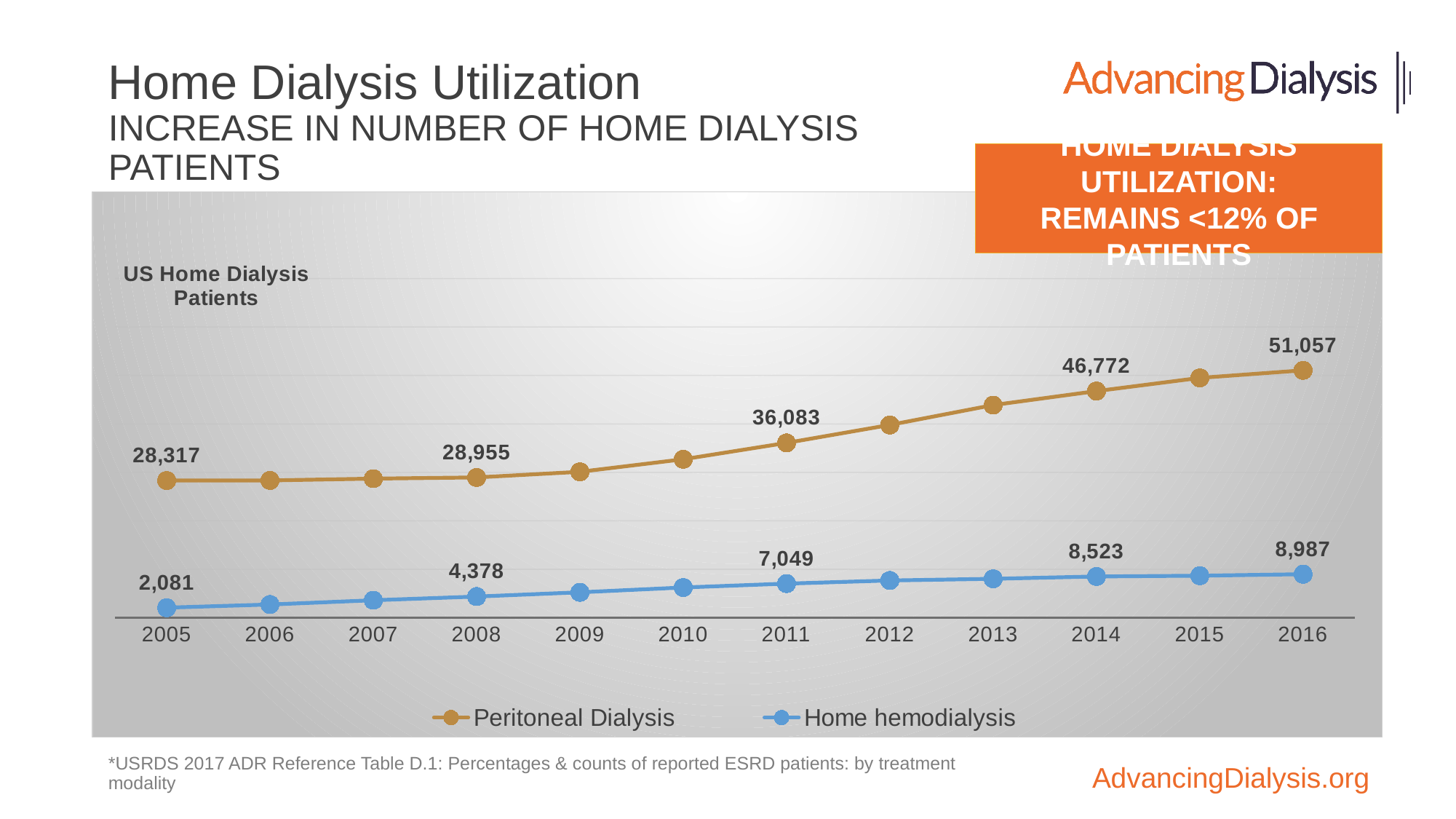
How many series does the legend list? 2 What is the number of Peritoneal Dialysis patients in 2011? 36,083 Which series has the larger value in 2014, Peritoneal Dialysis or Home hemodialysis? Peritoneal Dialysis What is the difference between the Peritoneal Dialysis values in 2016 and 2005? 22,740 How many years are shown on the x axis? 12 What is the number of Peritoneal Dialysis patients in 2005? 28,317 In which year is the Home hemodialysis value lowest? 2005 What type of chart is shown on the slide? Line chart What is the number of Home hemodialysis patients in 2016? 8,987 In which year is the Peritoneal Dialysis value highest? 2016 What is the number of Home hemodialysis patients in 2008? 4,378 Do the Home hemodialysis values rise or fall from 2005 to 2016? Rise